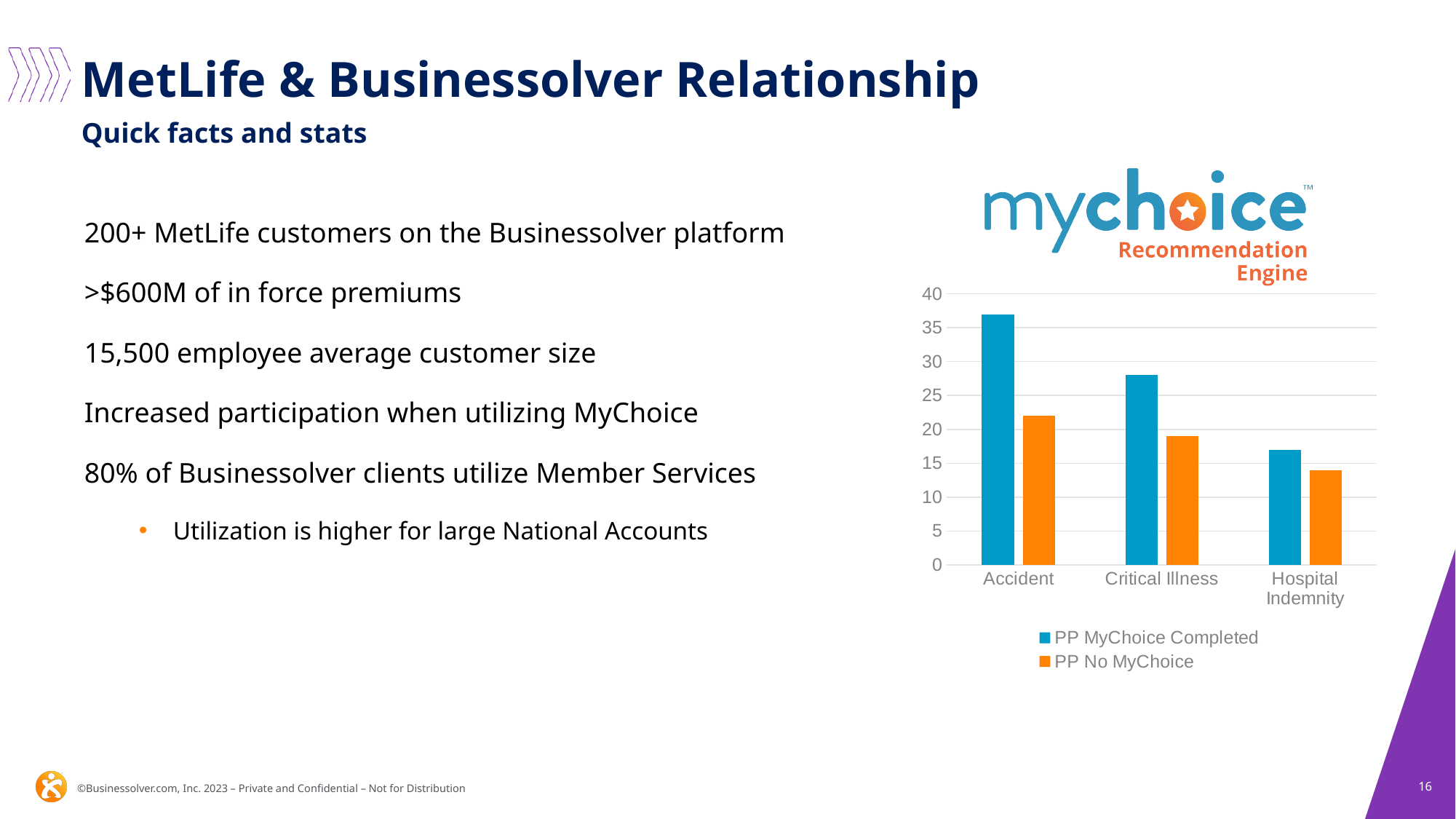
Which colour represents PP No MyChoice in the chart's legend? orange Is the PP MyChoice Completed value for Accident greater or less than 35? greater Is the PP No MyChoice value for Accident greater or less than 20? greater Is the PP MyChoice Completed value for Critical Illness greater or less than 25? greater Do the PP MyChoice Completed values rise or fall from Accident to Hospital Indemnity? fall What kind of chart is shown on the slide? bar chart How many series does the chart's legend list? 2 Which category has the lowest value for PP No MyChoice? Hospital Indemnity Which category has the highest value for PP MyChoice Completed? Accident How many categories are shown on the x axis of the chart? 3 For Accident, which is larger: PP MyChoice Completed or PP No MyChoice? PP MyChoice Completed